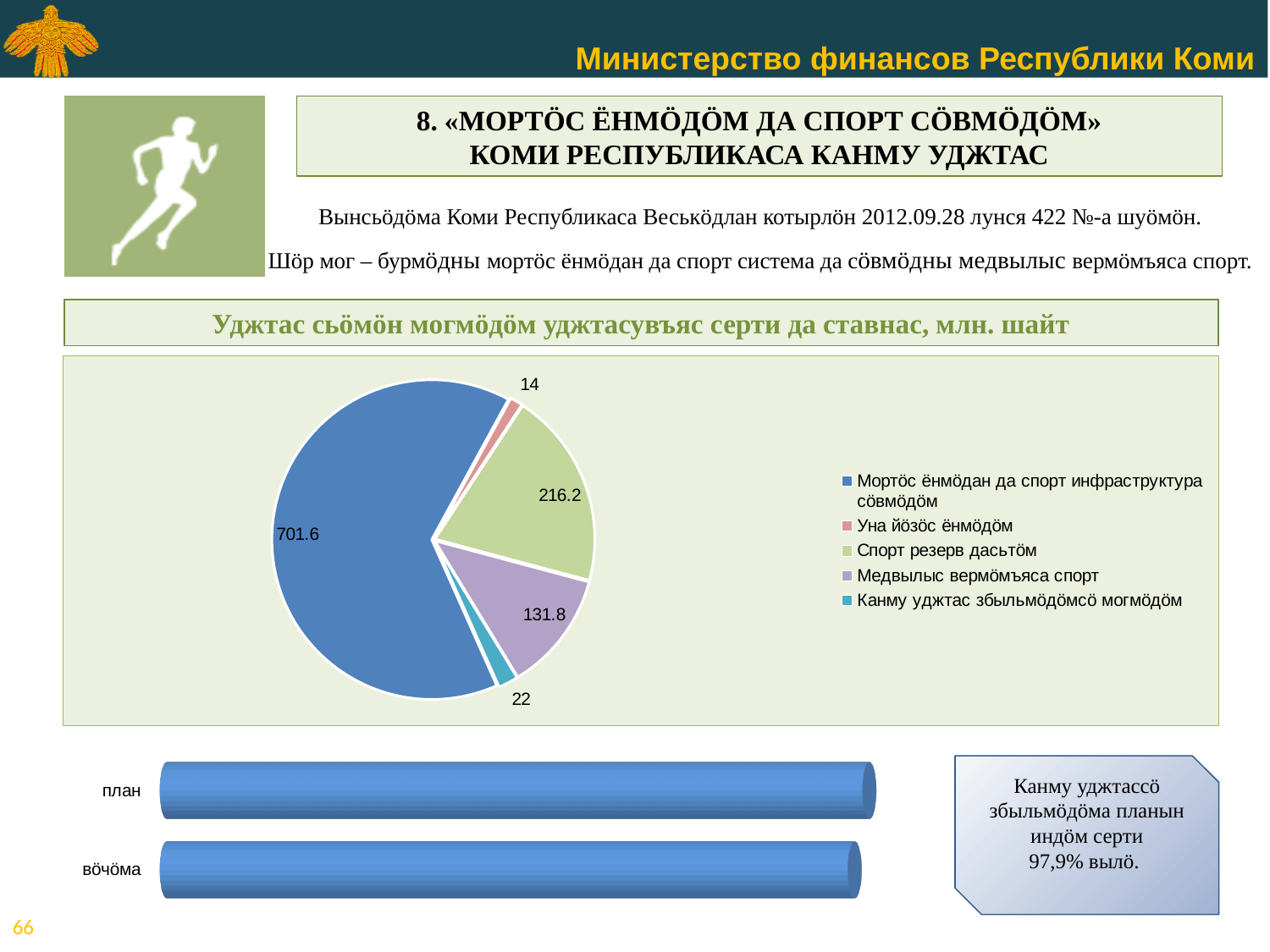
On the pie chart, what is the value for «Канму уджтас збыльмöдöмсö могмöдöм»? 22 On the pie chart, which is larger: the value for «Канму уджтас збыльмöдöмсö могмöдöм» or the value for «Уна йöзöс ёнмöдöм»? Канму уджтас збыльмöдöмсö могмöдöм On the lower bar chart, which bar is longer: «план» or «вöчöма»? план On the pie chart, what is the value for «Мортöс ёнмöдан да спорт инфраструктура сöвмöдöм»? 701.6 What type of chart is the lower chart on the slide, with the categories «план» and «вöчöма»? Bar chart On the pie chart, what is the difference between the values for «Спорт резерв дасьтöм» and «Медвылыс вермöмъяса спорт»? 84.4 On the pie chart, what is the value for «Медвылыс вермöмъяса спорт»? 131.8 On the pie chart, what is the value for «Спорт резерв дасьтöм»? 216.2 How many entries does the legend of the pie chart list? 5 On the pie chart, which category has the largest value? Мортöс ёнмöдан да спорт инфраструктура сöвмöдöм What type of chart is the upper chart on the slide? Pie chart On the pie chart, which category has the smallest value? Уна йöзöс ёнмöдöм